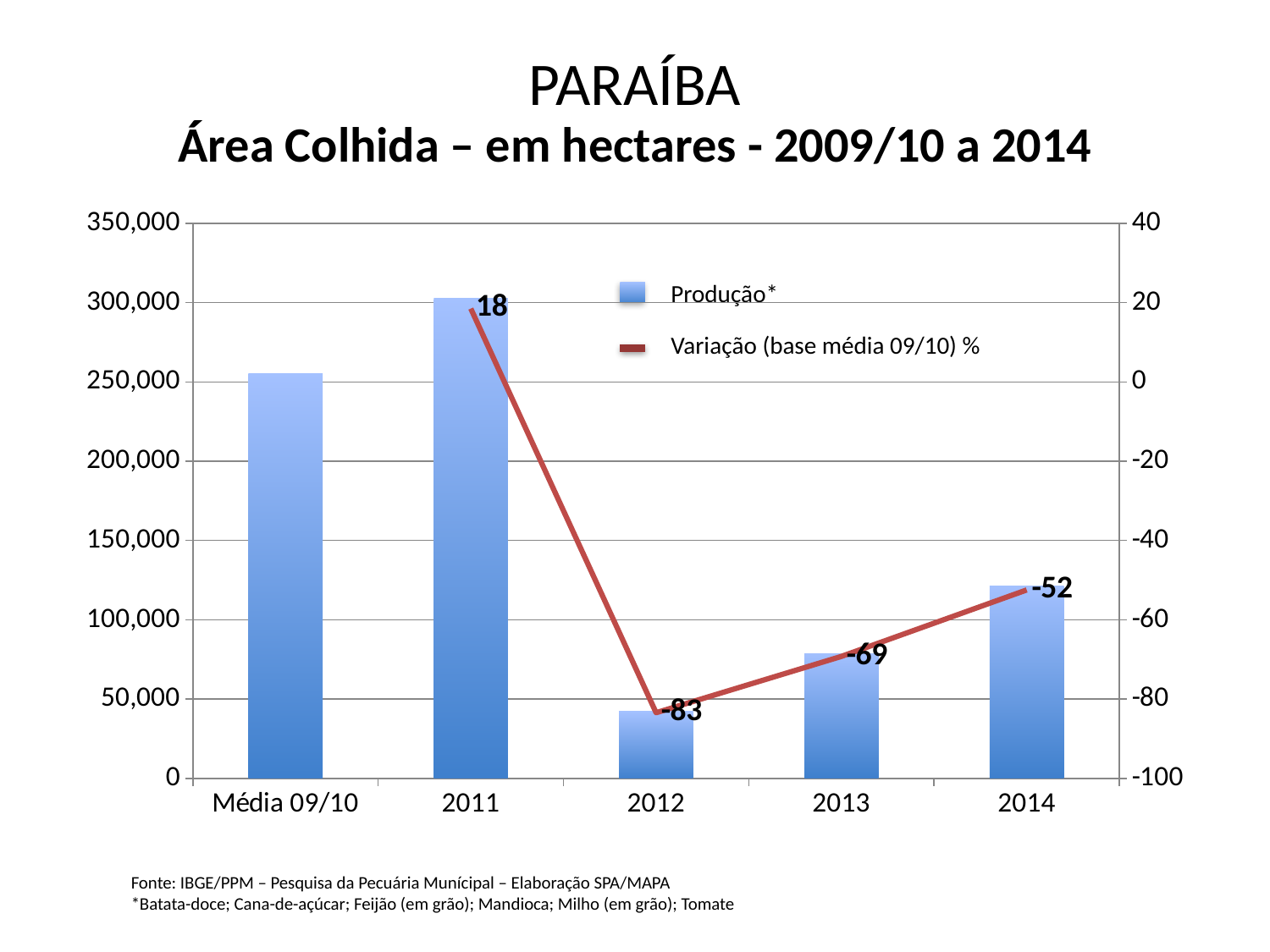
How many series does the legend list? 2 Which category has the tallest Produção* bar? 2011 Which has the larger Produção* bar, 2013 or 2014? 2014 What is the difference between the Variação values for 2011 and 2012? 101 Is the Produção* value for Média 09/10 greater or less than 200,000? greater Which category has the shortest Produção* bar? 2012 Does the Variação line rise or fall from 2012 to 2014? rises What is the value of Variação (base média 09/10) % for 2011? 18 Which year has the lowest Variação (base média 09/10) % value? 2012 How many categories are shown on the x axis? 5 What is the value of Variação (base média 09/10) % for 2012? -83 What is the value of Variação (base média 09/10) % for 2014? -52